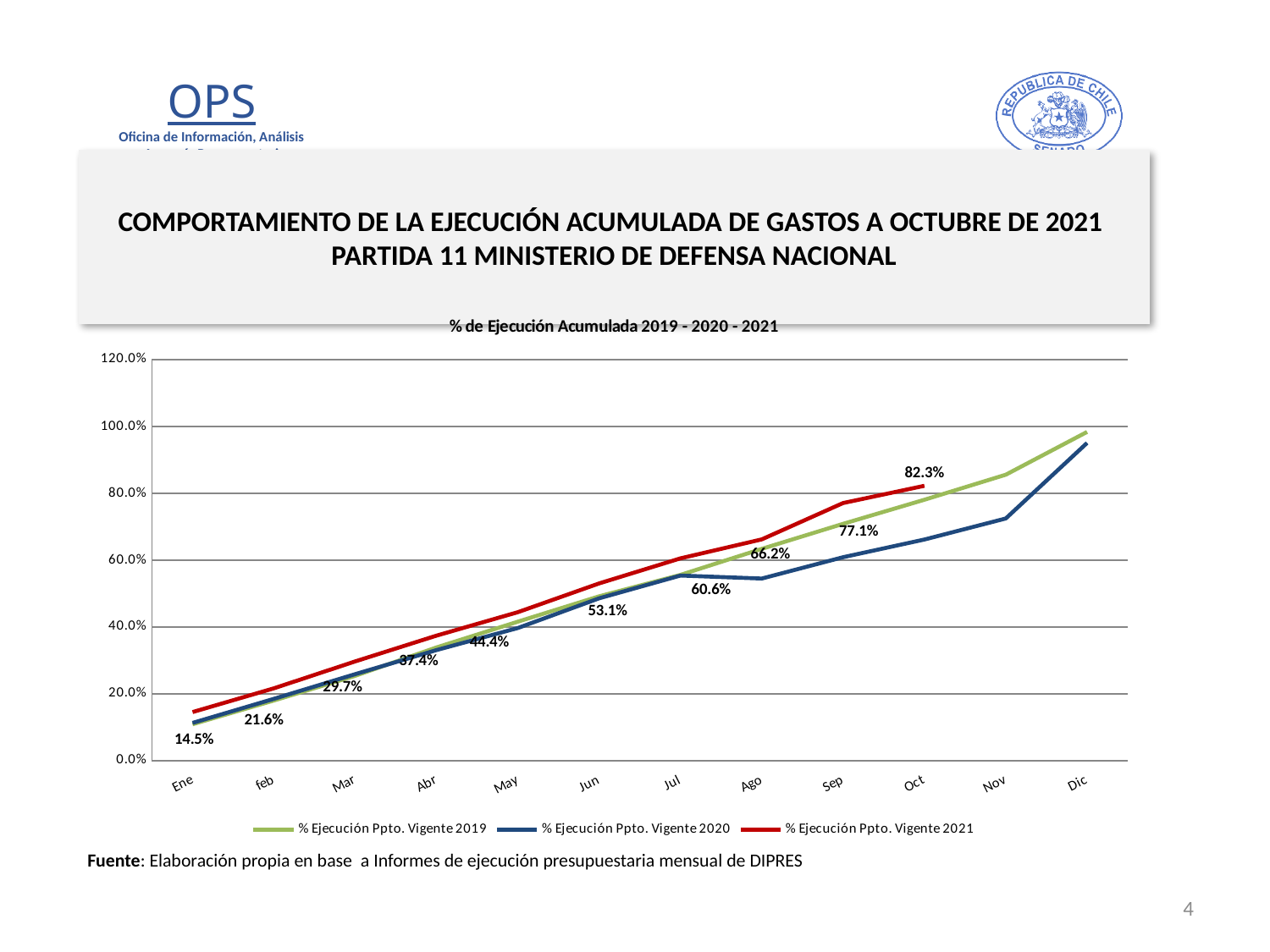
What is the value for % Ejecución Ppto. Vigente 2021 in Jun? 53.1% What is the chart's title? % de Ejecución Acumulada 2019 - 2020 - 2021 What kind of chart is shown on the slide? line chart What is the value for % Ejecución Ppto. Vigente 2021 in Oct? 82.3% What is the value for % Ejecución Ppto. Vigente 2021 in Ene? 14.5% What is the difference between the 2021 values for Sep and Ago? 10.9% Does the % Ejecución Ppto. Vigente 2021 series rise or fall from Ene to Oct? rise What is the difference between the 2021 values for Oct and Ene? 67.8% How many months are shown on the x axis? 12 Which series has the higher value in Sep, % Ejecución Ppto. Vigente 2021 or % Ejecución Ppto. Vigente 2020? % Ejecución Ppto. Vigente 2021 Is the value for % Ejecución Ppto. Vigente 2020 in Dic greater or less than 80.0%? greater How many series does the legend list? 3